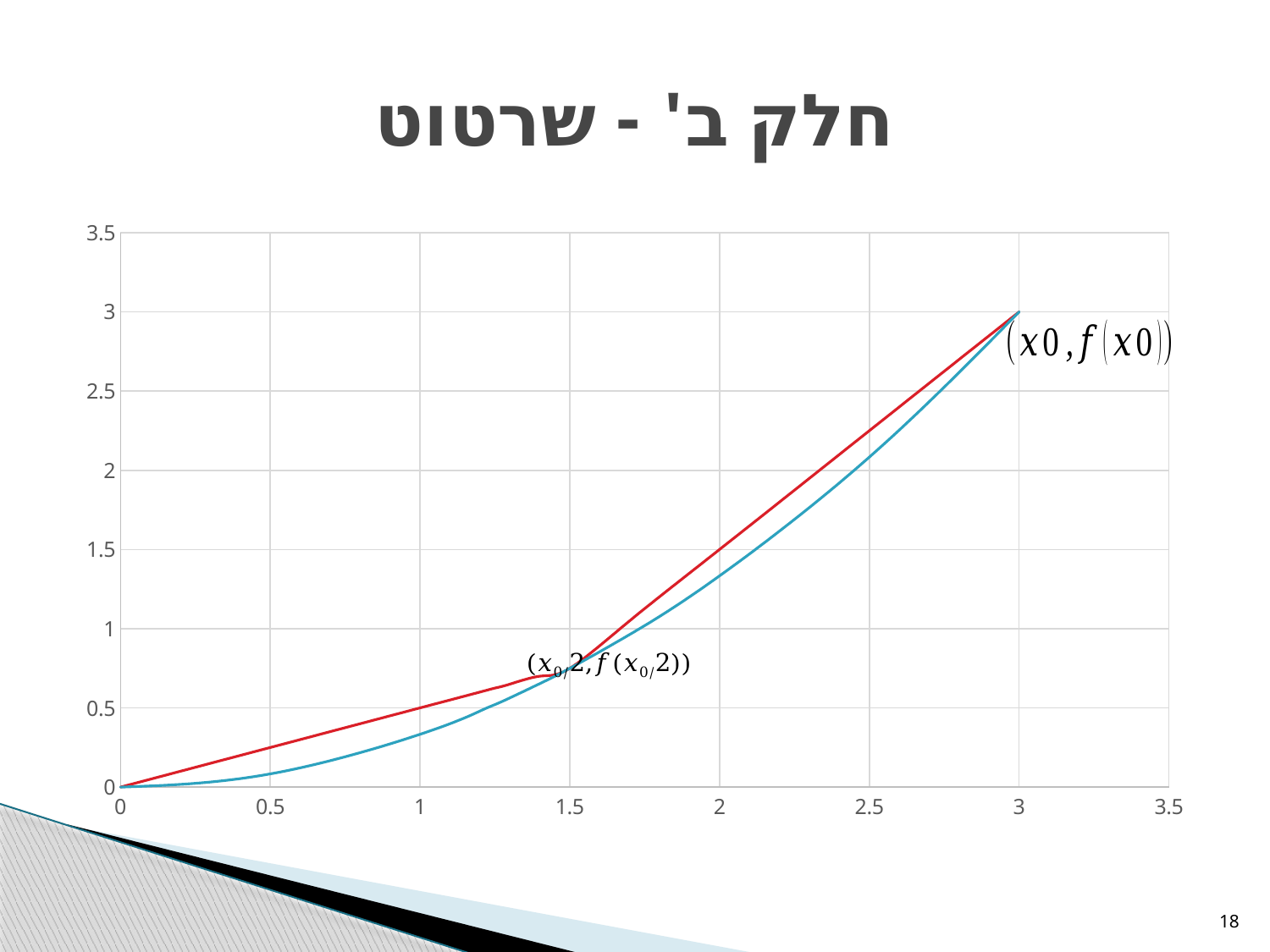
At x = 2.5, which line is higher, the red line or the blue line? red line At what x value do the red and blue lines meet at their upper right endpoint? 3 At x = 1, which line is higher, the red line or the blue line? red line What label is written next to the upper right endpoint of the lines? (x0, f(x0)) What is the y value where the red and blue lines meet at their upper right endpoint? 3 At x = 2.5, is the red line greater or less than 2.5? less At x = 1, is the red line greater or less than 1? less How many lines are plotted on the chart? 2 Do the plotted lines rise or fall as x increases from 0 to 3? rise What is the highest value shown on the y axis? 3.5 What kind of chart is shown on the slide? line chart At x = 2, is the blue line greater or less than 1? greater